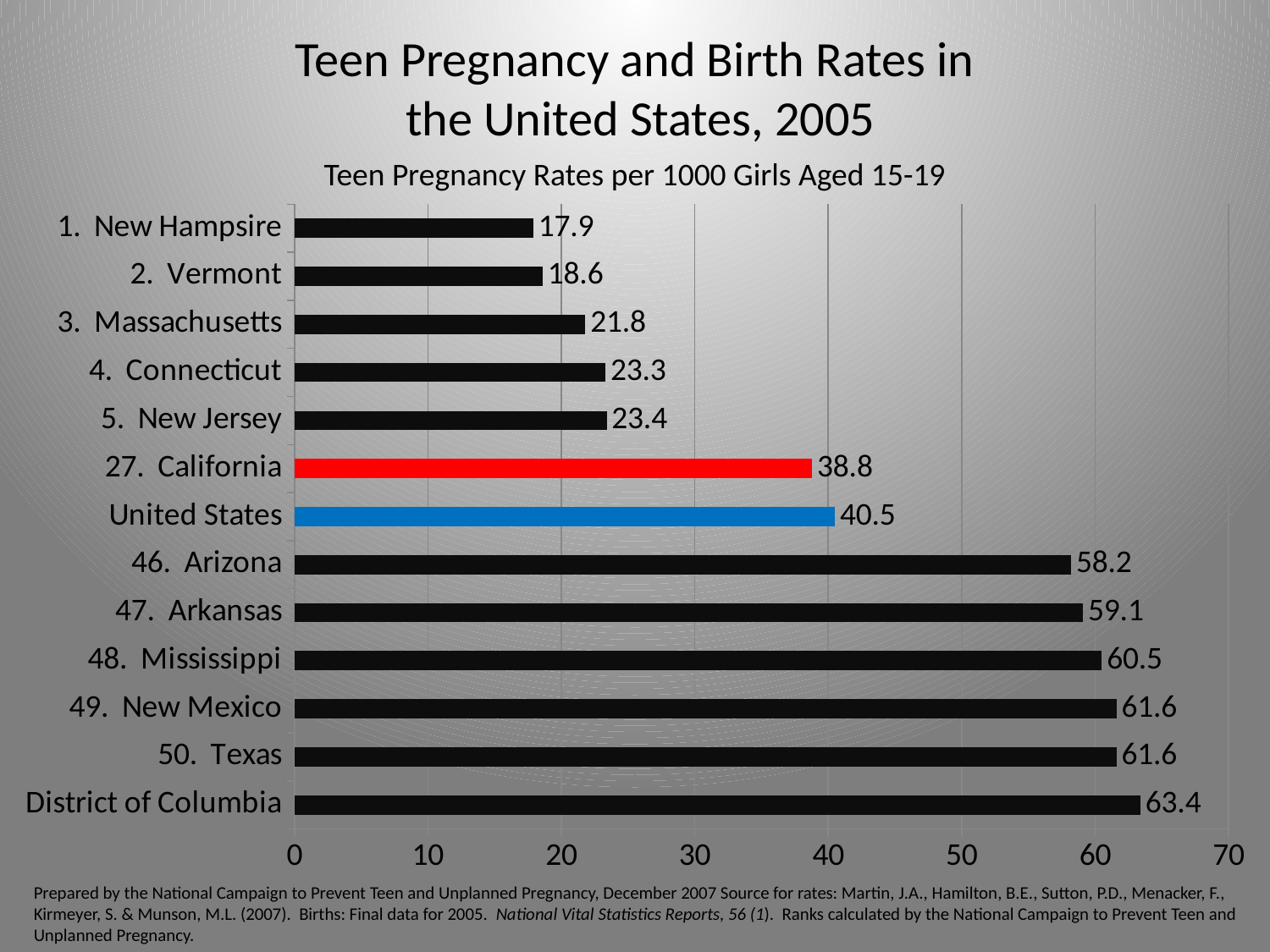
What is the teen pregnancy rate for the United States overall? 40.5 What is the teen pregnancy rate for California? 38.8 What is the difference between the teen pregnancy rates of District of Columbia and New Hampshire? 45.5 Which bar is coloured red on the chart? California What is the difference between the teen pregnancy rates of the United States and California? 1.7 What kind of chart is shown on the slide? Bar chart Which category has the highest teen pregnancy rate on the chart? District of Columbia What is the teen pregnancy rate for New Hampshire? 17.9 Which category has the lowest teen pregnancy rate on the chart? New Hampshire Which has a higher teen pregnancy rate, Arizona or Arkansas? Arkansas How many bars are shown on the chart? 13 Is the value for Mississippi greater or less than 60? greater